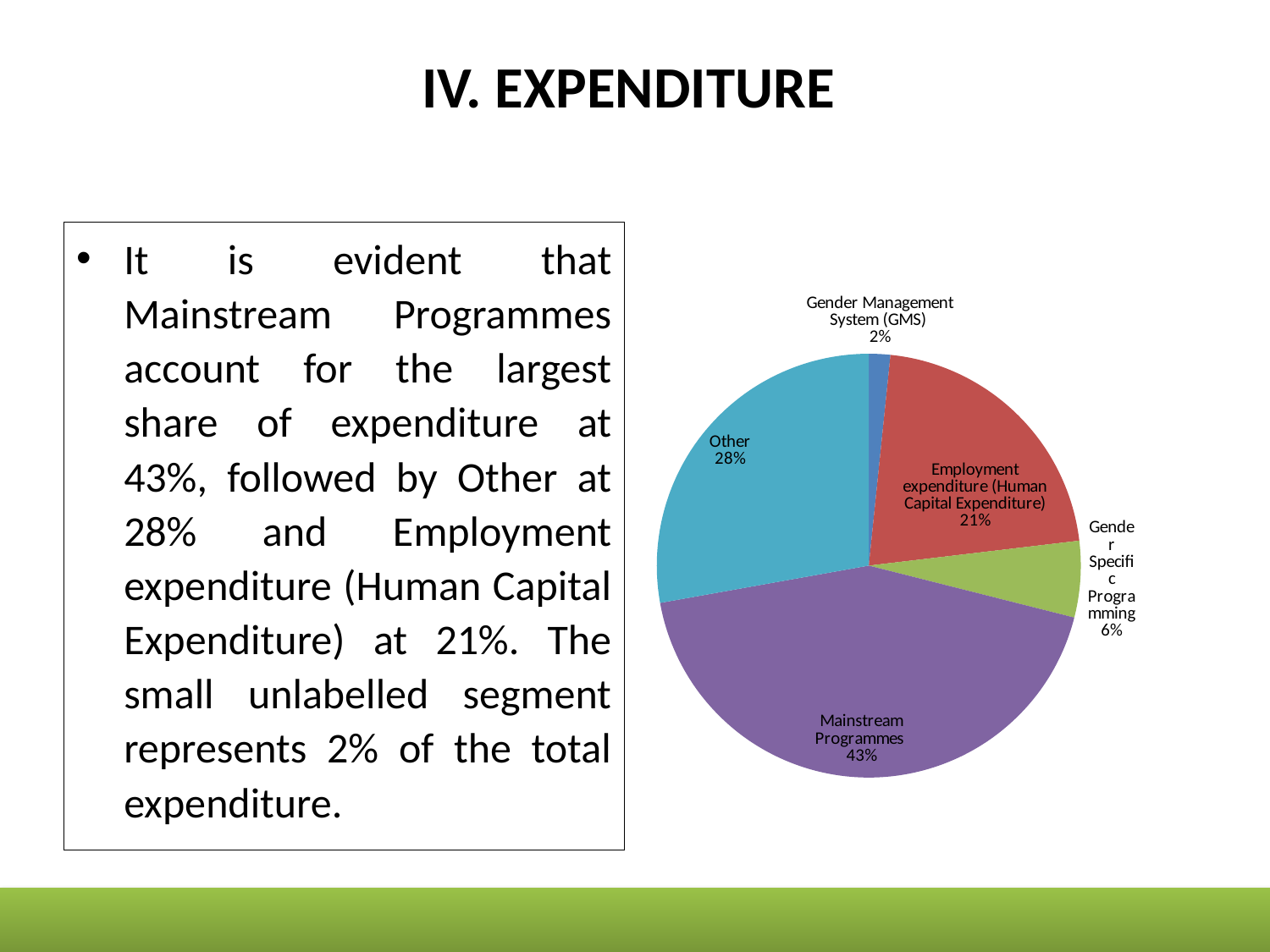
What colour is the Mainstream Programmes slice? Purple Which is larger, the share for Other or the share for Employment expenditure (Human Capital Expenditure)? Other What share of expenditure does Mainstream Programmes account for? 43% What is the difference in percentage points between Mainstream Programmes and Other? 15 What share is labelled for Employment expenditure (Human Capital Expenditure)? 21% What share of the pie is Gender Management System (GMS)? 2% What percentage is shown for Other? 28% Which category has the smallest share of expenditure? Gender Management System (GMS) Which category has the largest share of expenditure? Mainstream Programmes What percentage is shown for Gender Specific Programming? 6% What kind of chart is shown on the slide? Pie chart How many slices does the pie chart have? 5